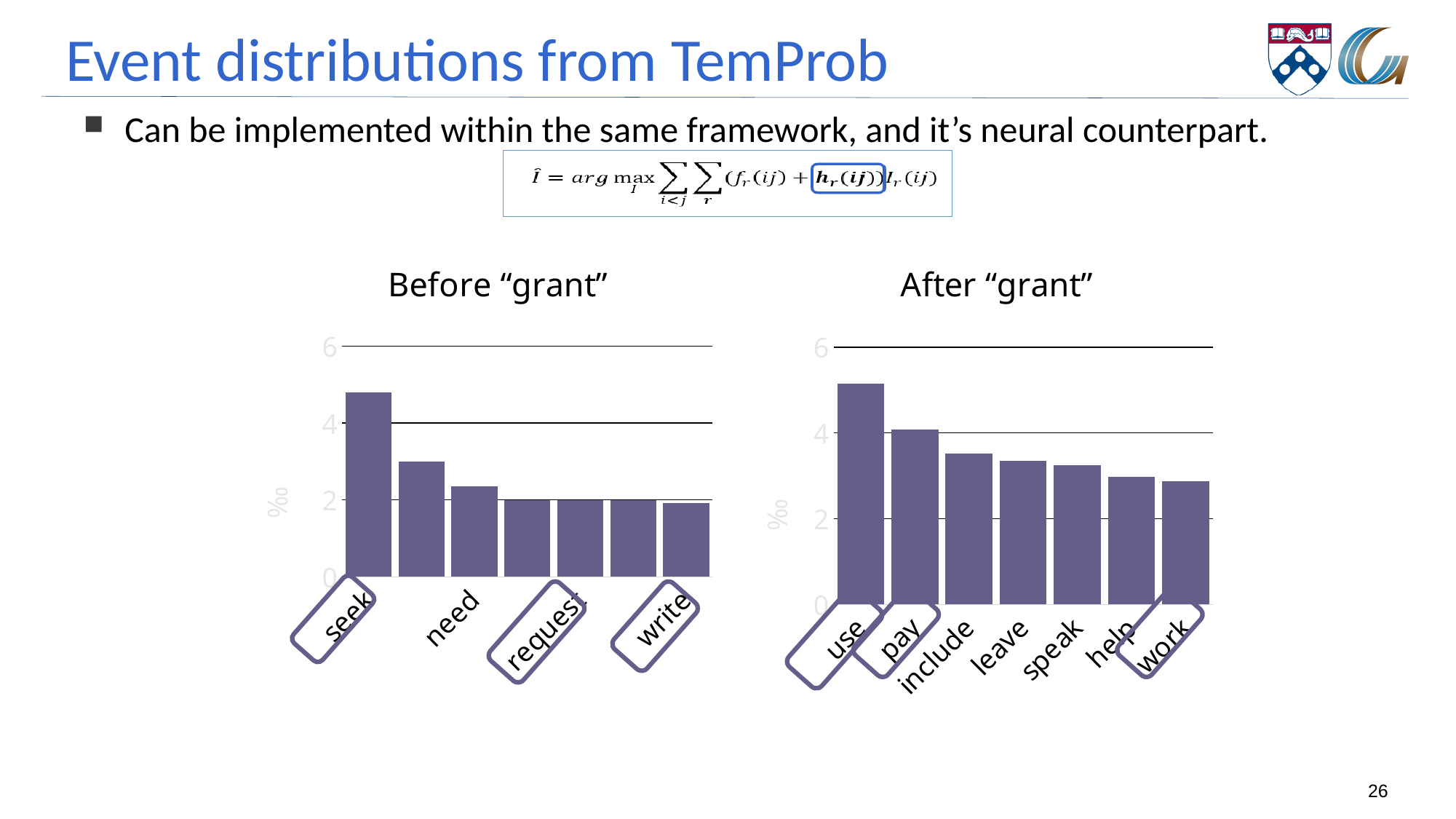
In the "After "grant"" chart, do the values rise or fall from left to right? fall In the "Before "grant"" chart, is the value for need greater or less than 4? less In the "After "grant"" chart, which category has the highest value? use What kind of chart is the "Before "grant"" chart? bar chart In the "After "grant"" chart, is the value for include greater or less than 4? less In the "Before "grant"" chart, which category has the highest value? seek In the "After "grant"" chart, which is larger, the value for use or the value for include? use In the "Before "grant"" chart, is the value for seek greater or less than 4? greater What is the y-axis label on the "Before "grant"" chart? ‰ How many bars does the "After "grant"" chart have? 7 How many bars does the "Before "grant"" chart have? 7